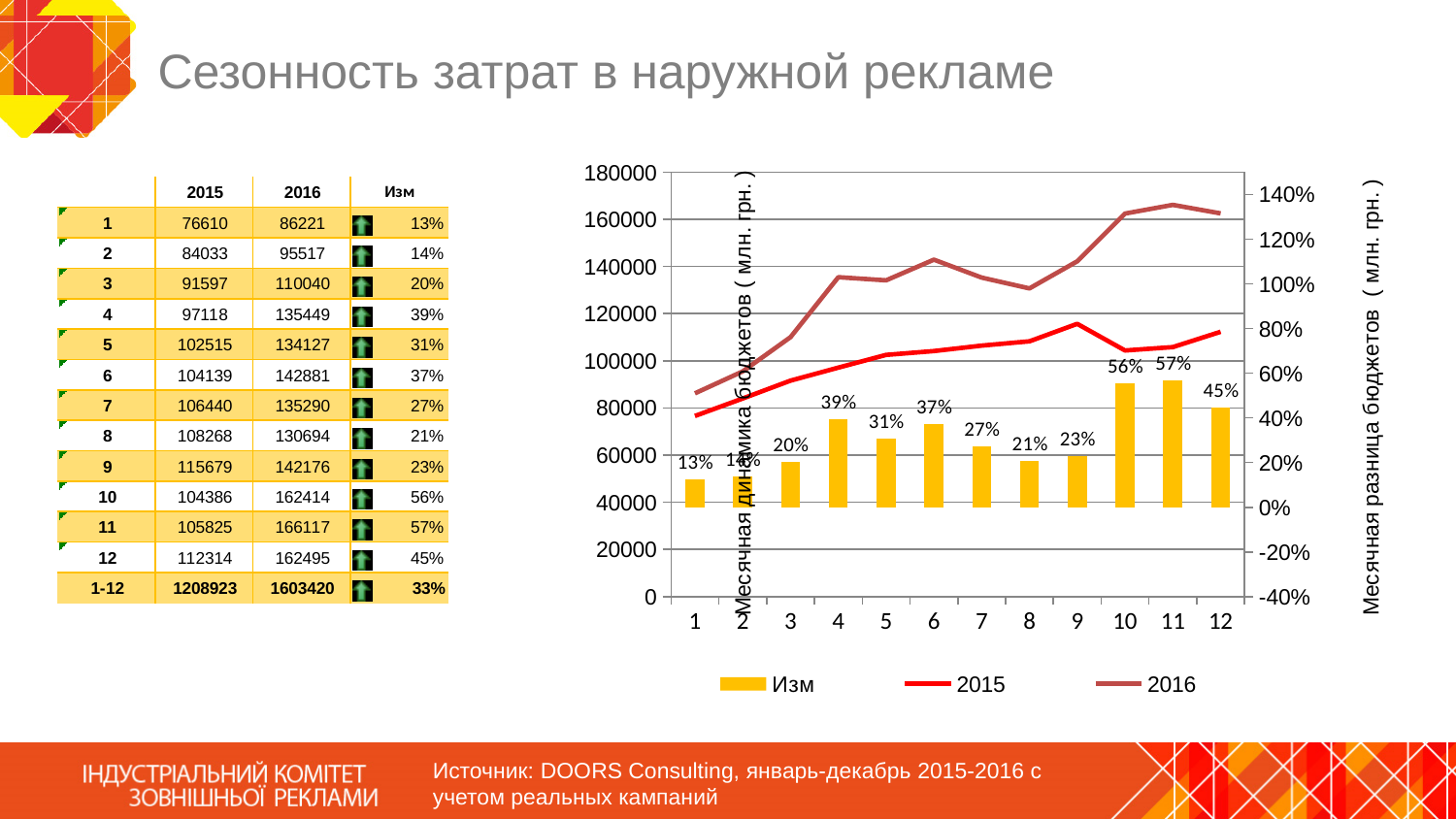
Is the 2016 line value for month 11 greater or less than 160000? greater What is the value of the Изм bar for month 12? 45% What kind of chart is shown on the slide? Combined bar and line chart How many series does the chart legend list? 3 What is the value of the Изм bar for month 10? 56% What is the difference between the Изм values for month 11 and month 1? 44 percentage points Which is larger, the Изм value for month 6 or for month 7? month 6 Which month has the lowest Изм bar? 1 Which month has the highest Изм bar? 11 How many months are shown on the x axis of the chart? 12 What is the value of the Изм bar for month 4? 39% Is the 2015 line value for month 1 greater or less than 80000? less